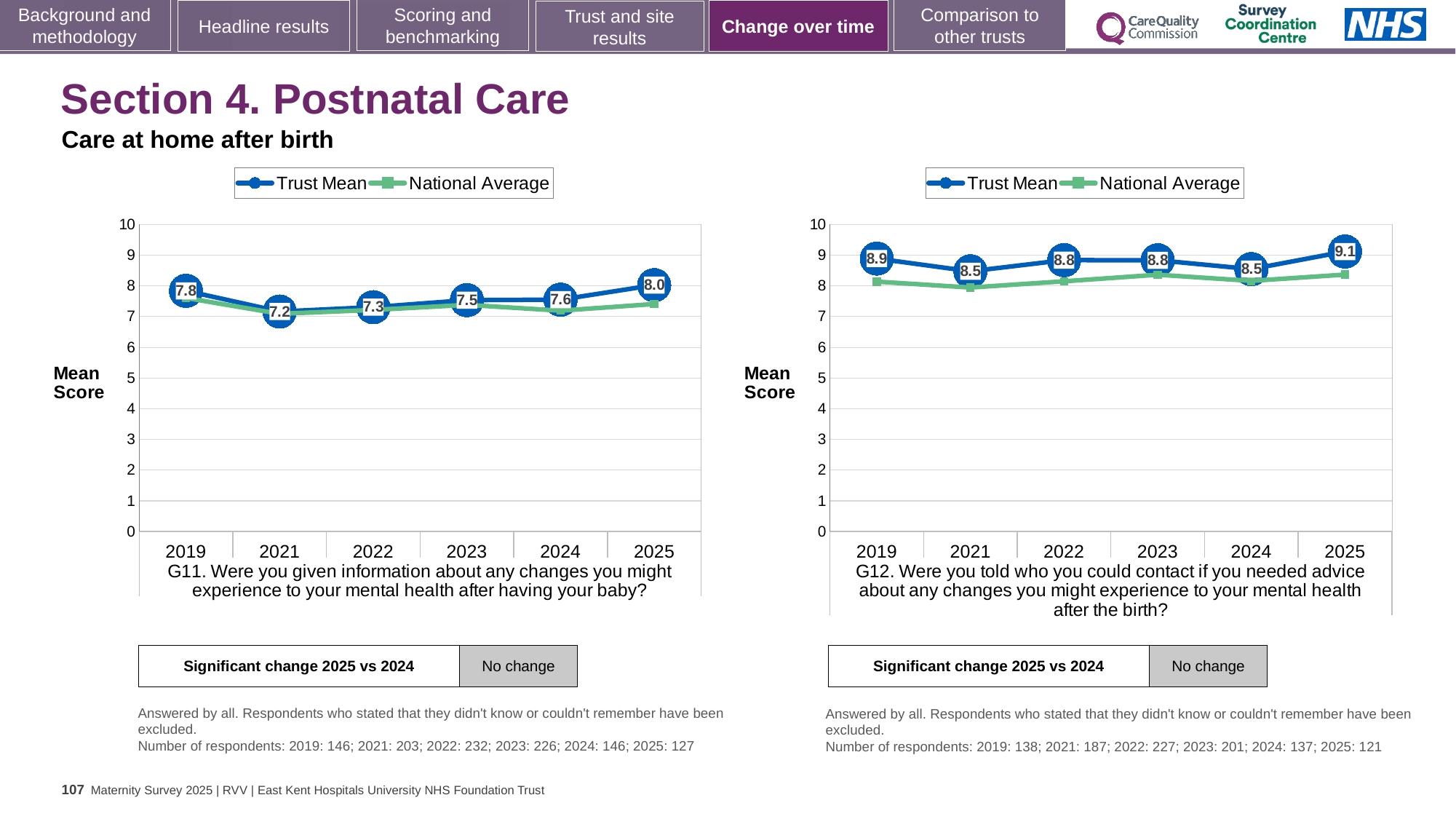
How many years are plotted on the x axis of the G11 chart (left)? 6 In the G11 chart (left), which year has the highest Trust Mean? 2025 In the G12 chart (right), is the National Average for 2025 greater or less than 9? less How many series does the legend of the G12 chart (right) list? 2 What type of chart is the G11 chart (left)? Line chart In the G11 chart (left), what is the Trust Mean for 2021? 7.2 In the G11 chart (left), which year has the lowest Trust Mean? 2021 In the G12 chart (right), what is the Trust Mean for 2019? 8.9 In the G11 chart (left), what is the difference between the Trust Mean in 2025 and in 2021? 0.8 In the G11 chart (left), what is the Trust Mean for 2025? 8.0 In the G12 chart (right), what is the difference between the Trust Mean in 2025 and in 2024? 0.6 In the G12 chart (right), which year has the highest Trust Mean? 2025